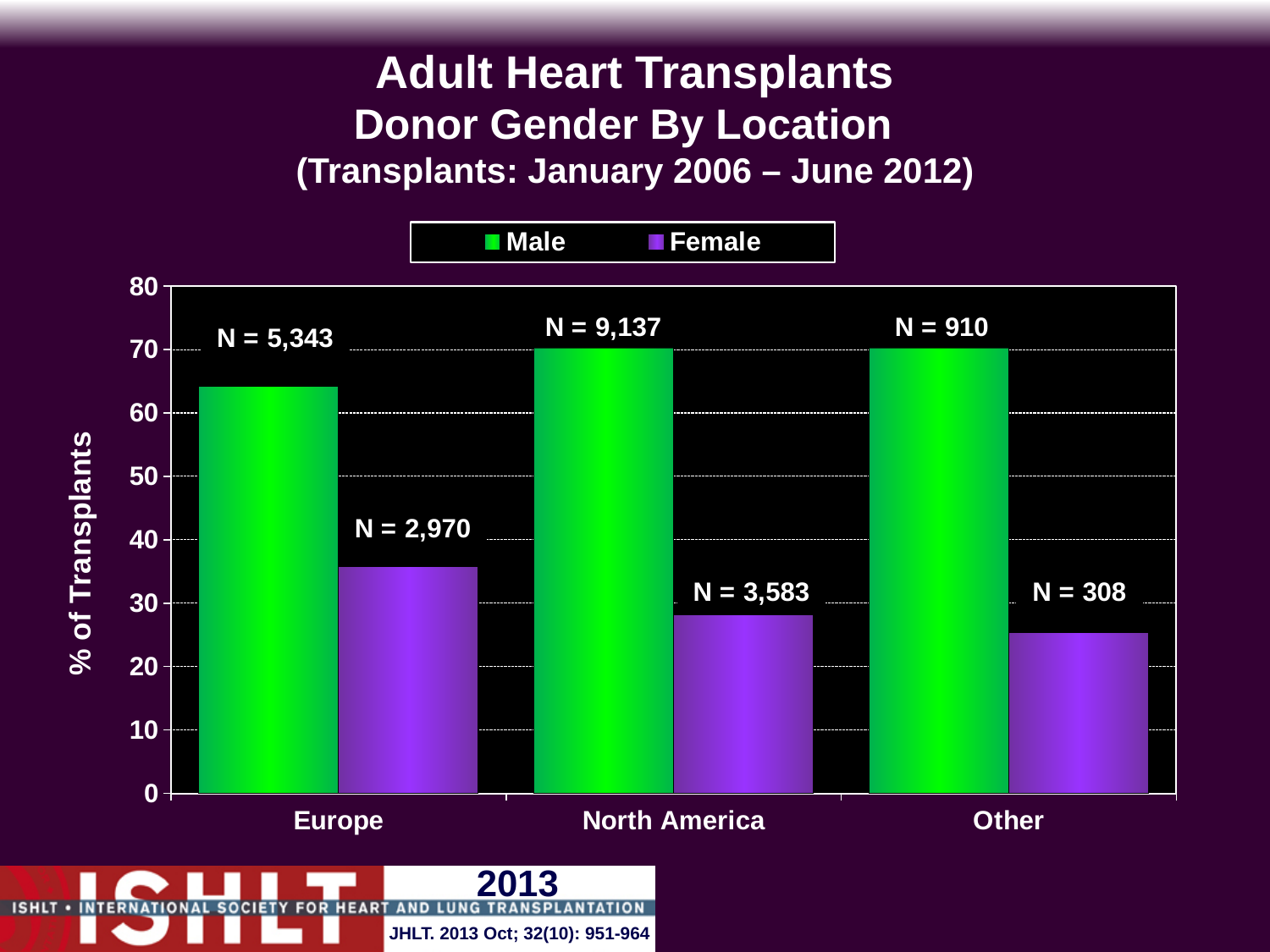
What kind of chart is shown on the slide? bar chart What is the N value printed above the Male bar for Europe? N = 5,343 What is the N value printed above the Female bar for Other? N = 308 What is the N value printed above the Female bar for North America? N = 3,583 How many series does the legend list? 2 What is the N value printed above the Male bar for Other? N = 910 Is the Male percentage for Europe greater or less than 60? greater Is the Female percentage for North America greater or less than 30? less Which location has the lowest Female percentage of transplants? Other Which is larger for Europe, the Male percentage or the Female percentage? Male How many location categories are shown on the x axis? 3